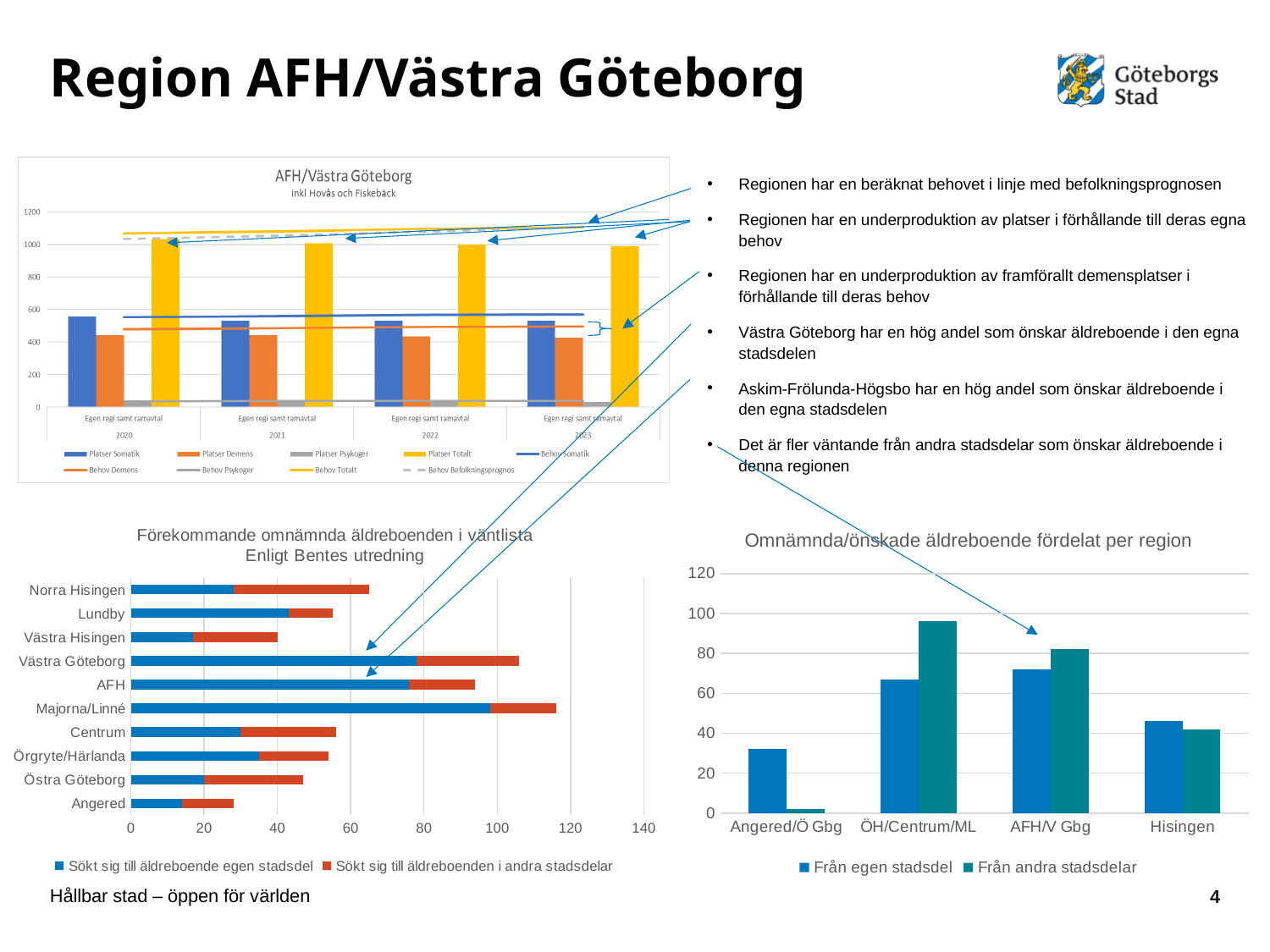
In the 'AFH/Västra Göteborg' chart at the top left, how many series does the legend list? 9 In the 'Omnämnda/önskade äldreboende fördelat per region' chart, which region has the highest value for 'Från andra stadsdelar'? ÖH/Centrum/ML In the 'Omnämnda/önskade äldreboende fördelat per region' chart, how many regions are shown on the x axis? 4 In the 'Omnämnda/önskade äldreboende fördelat per region' chart, is the 'Från egen stadsdel' value for AFH/V Gbg greater or less than 60? greater In the 'Omnämnda/önskade äldreboende fördelat per region' chart, how many series does the legend list? 2 What kind of chart is the 'Omnämnda/önskade äldreboende fördelat per region' chart at the bottom right? Bar chart In the 'Omnämnda/önskade äldreboende fördelat per region' chart, for Angered/Ö Gbg, which is larger: 'Från egen stadsdel' or 'Från andra stadsdelar'? Från egen stadsdel In the 'Förekommande omnämnda äldreboenden i väntlista' chart at the bottom left, how many categories are listed on the vertical axis? 10 In the 'Omnämnda/önskade äldreboende fördelat per region' chart, which region has the lowest value for 'Från andra stadsdelar'? Angered/Ö Gbg In the 'Förekommande omnämnda äldreboenden i väntlista' chart, which category has the highest value for 'Sökt sig till äldreboende egen stadsdel'? Majorna/Linné In the 'Förekommande omnämnda äldreboenden i väntlista' chart, is the 'Sökt sig till äldreboende egen stadsdel' value for Majorna/Linné greater or less than 80? greater In the 'AFH/Västra Göteborg' chart at the top left, is the 'Platser Somatik' value for 2020 greater or less than 600? less